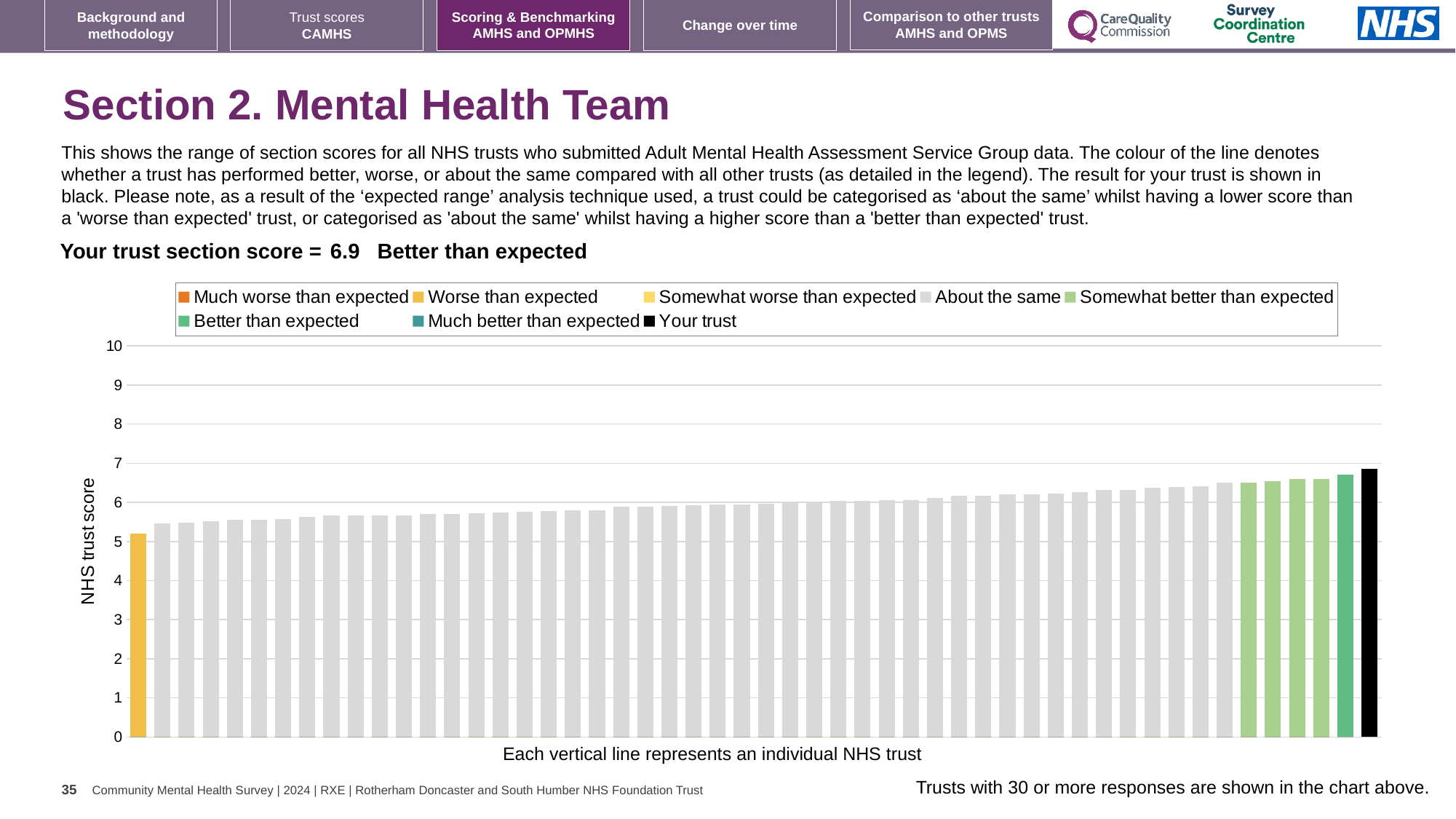
Which bar is the tallest in the chart? Your trust (the black bar) Which legend category does the shortest bar in the chart belong to? Worse than expected What kind of chart is shown on the slide? bar chart What is the label on the vertical axis of the chart? NHS trust score How many entries does the chart legend list? 8 Which category is your trust placed in according to the slide? Better than expected Is the value of the leftmost (yellow) bar greater or less than 5? greater Do the bar values rise or fall from left to right along the x axis? rise What is the section score for your trust shown on the slide? 6.9 Which is taller, the black 'Your trust' bar or the yellow leftmost bar? the black 'Your trust' bar Is the value of the leftmost (yellow) bar greater or less than 6? less Is the value of the black 'Your trust' bar greater or less than 6? greater